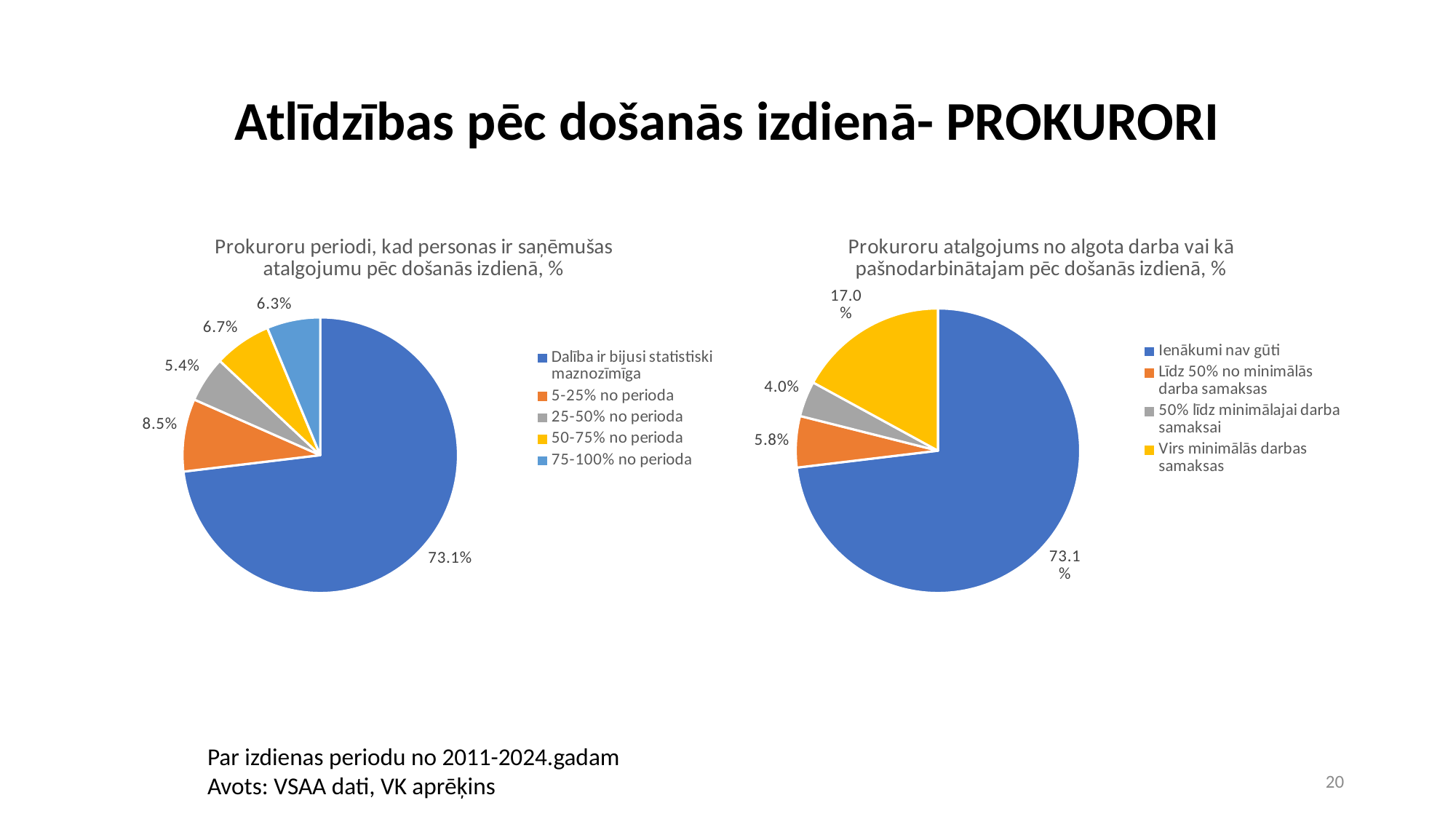
In the left chart, what is the value for '50-75% no perioda'? 6.7% In the left chart, what share of the pie is labelled 'Dalība ir bijusi statistiski maznozīmīga'? 73.1% What type of chart is the right chart? Pie chart In the left chart, which is larger: '50-75% no perioda' or '75-100% no perioda'? 50-75% no perioda In the left chart, what is the difference between '5-25% no perioda' and '25-50% no perioda'? 3.1% In the left chart, what is the value for '5-25% no perioda'? 8.5% In the right chart, what is the value for '50% līdz minimālajai darba samaksai'? 4.0% In the right chart, which category has the largest slice? Ienākumi nav gūti In the left chart, which category has the smallest slice? 25-50% no perioda In the right chart, what is the value for 'Virs minimālās darbas samaksas'? 17.0% How many slices does the left pie chart have? 5 In the right chart, what is the difference between 'Virs minimālās darbas samaksas' and 'Līdz 50% no minimālās darba samaksas'? 11.2%